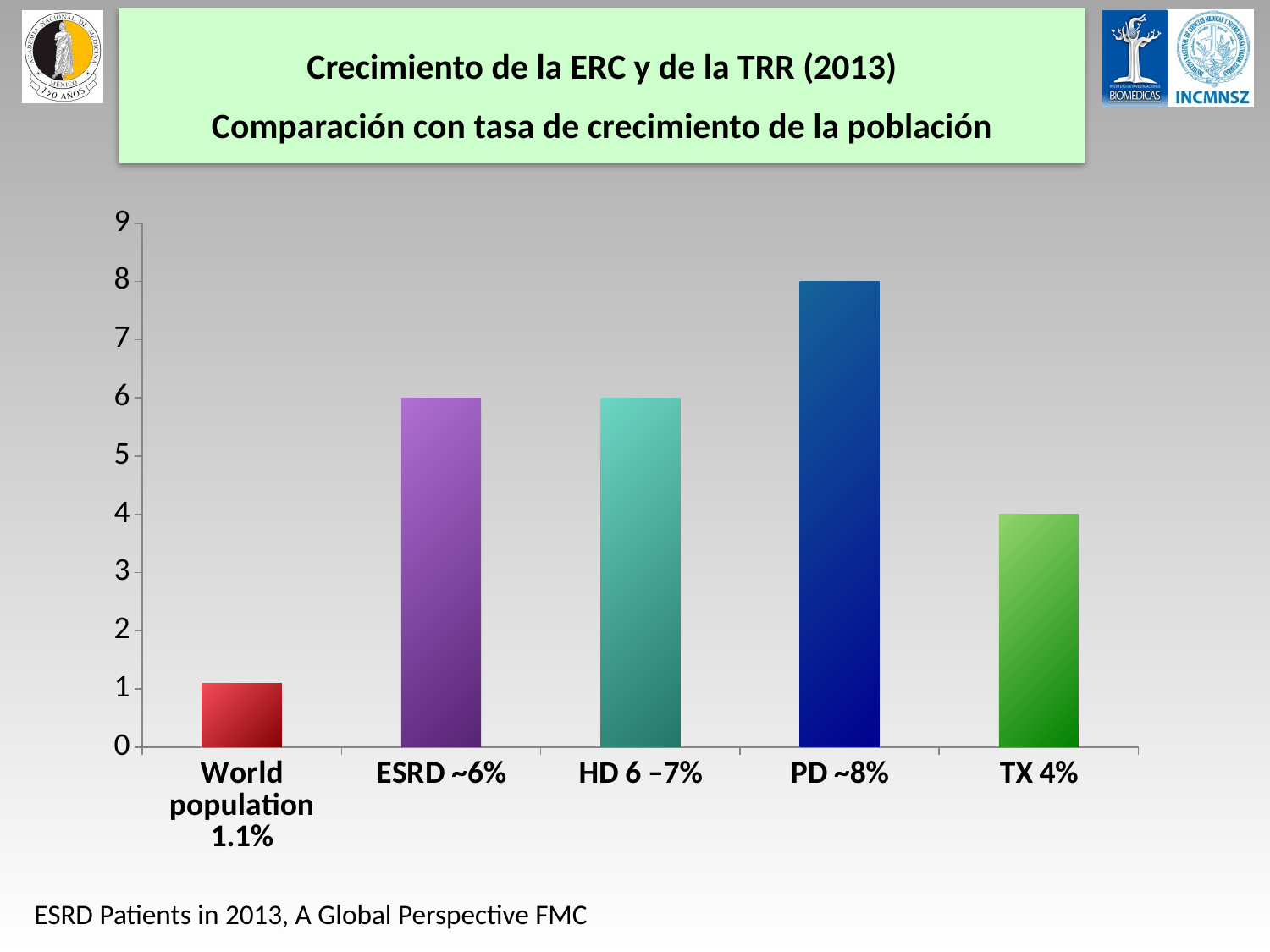
What is the first line of the title shown above the chart? Crecimiento de la ERC y de la TRR (2013) Which category has the lowest bar? World population 1.1% Which is larger, the bar for PD ~8% or the bar for TX 4%? PD ~8% What is the value of the bar for PD ~8%? 8 What is the highest value shown on the vertical axis? 9 How many categories are shown on the x axis of the chart? 5 What is the value of the bar for ESRD ~6%? 6 What is the difference between the bar for PD ~8% and the bar for TX 4%? 4 Which category has the highest bar? PD ~8% What type of chart is shown on the slide? Bar chart What is the value of the bar for TX 4%? 4 Is the value for World population 1.1% greater or less than 2? less